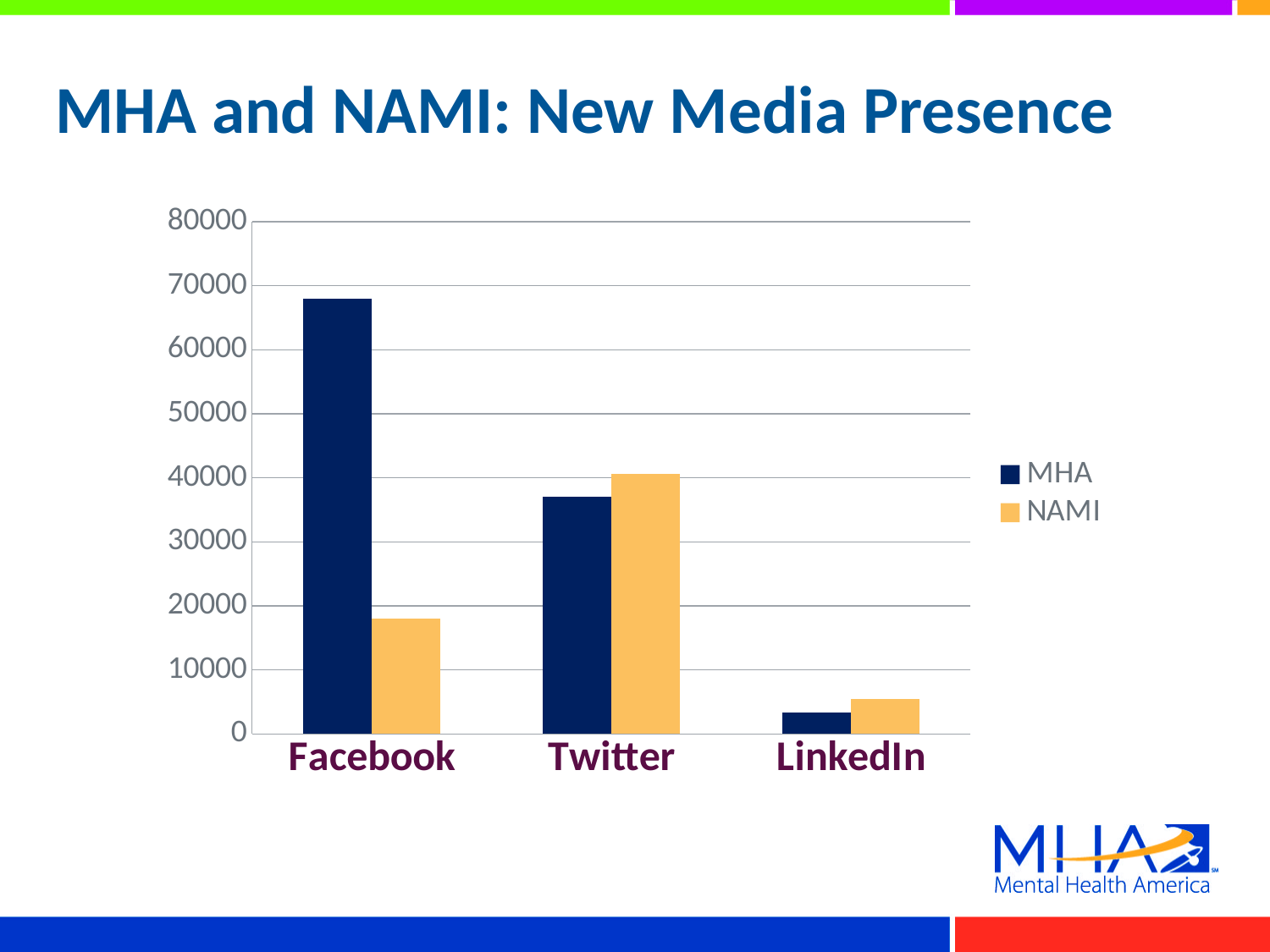
For Facebook, which is larger, the MHA value or the NAMI value? MHA Which category has the lowest NAMI value? LinkedIn For Twitter, which is larger, the MHA value or the NAMI value? NAMI Which category has the highest MHA value? Facebook How many categories are shown on the x axis? 3 What is the title of the slide containing the chart? MHA and NAMI: New Media Presence Is the MHA value for LinkedIn greater or less than 10000? less Is the MHA value for Facebook greater or less than 60000? greater How many series does the legend list? 2 Is the NAMI value for Facebook greater or less than 20000? less What kind of chart is shown on the slide? bar chart Which category has the highest NAMI value? Twitter